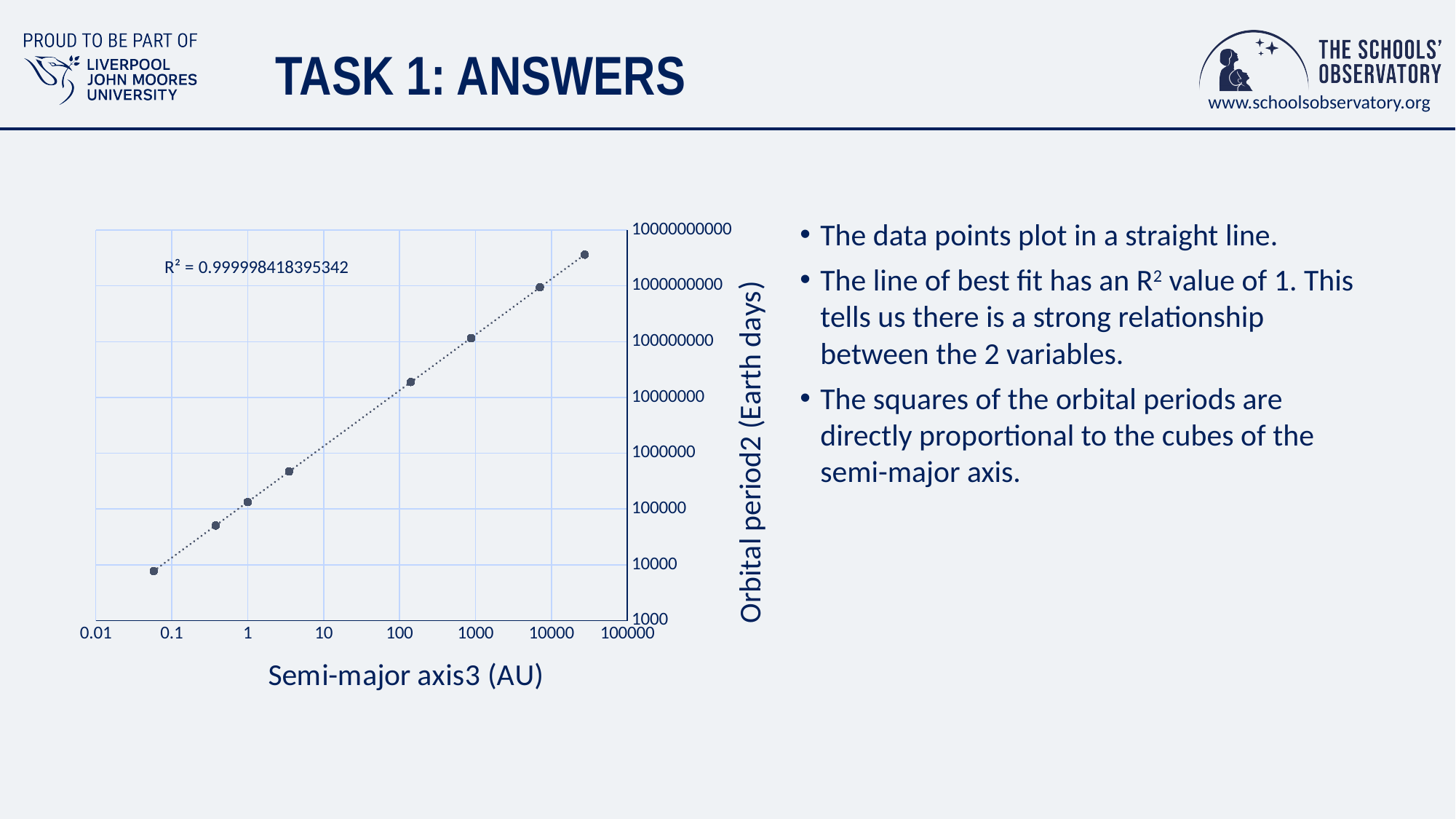
Which data point has the highest orbital period squared: the one furthest left or the one furthest right on the x axis? the one furthest right Is the value of the highest data point on the chart greater or less than 1000000000? greater What kind of chart is shown on the slide? scatter chart What R² value is printed on the chart? R² = 0.999998418395342 What is the label of the x axis of the chart? Semi-major axis3 (AU) Is the value of the data point at a semi-major axis cubed of about 100 AU greater or less than 10000000? greater How many data points are plotted on the chart? 8 What is the smallest value shown on the y axis of the chart? 1000 Is the value of the lowest data point on the chart greater or less than 10000? less Do the plotted values rise or fall as the semi-major axis cubed increases along the x axis? rise